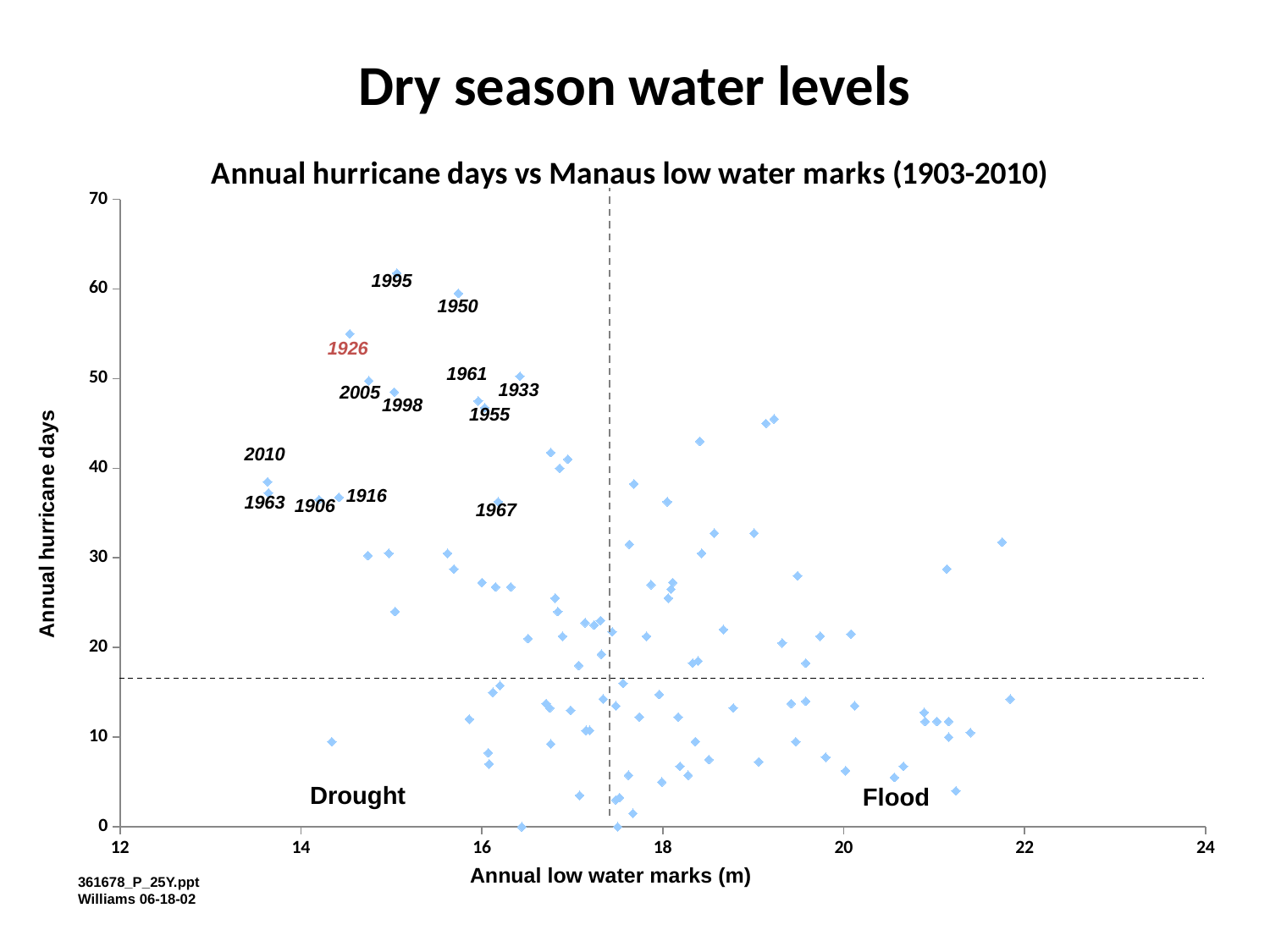
Which year has more annual hurricane days, 1995 or 1950? 1995 Is the number of annual hurricane days for 1926 greater or less than 50? greater What is the title of the chart? Annual hurricane days vs Manaus low water marks (1903-2010) Is the number of annual hurricane days for 2010 greater or less than 40? less Which year has more annual hurricane days, 1926 or 2005? 1926 What is the label of the x axis? Annual low water marks (m) Is the number of annual hurricane days for 1995 greater or less than 60? greater What kind of chart is shown on the slide? Scatter chart Among the labeled years, which year has the highest number of annual hurricane days? 1995